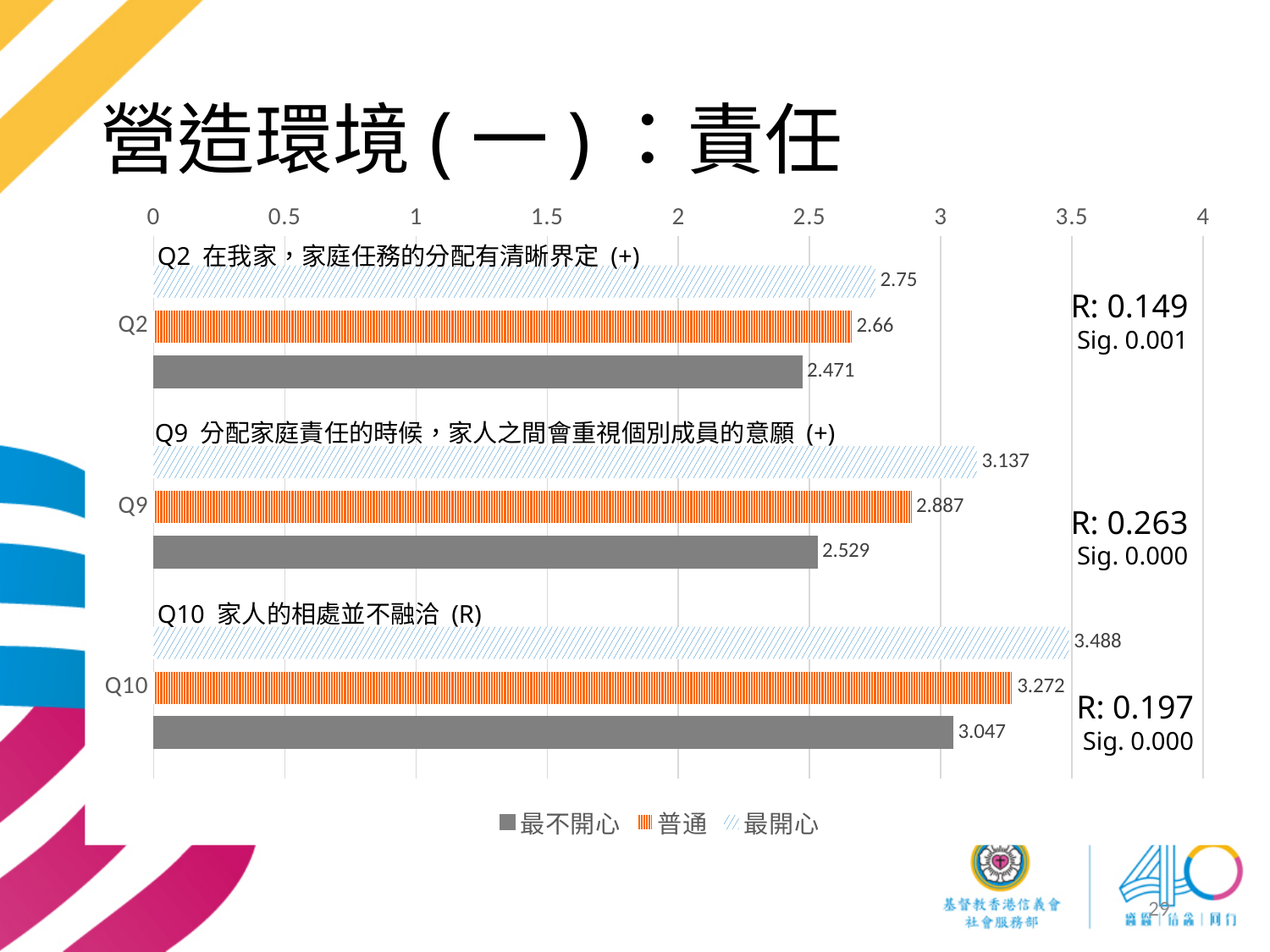
What is the value of 最不開心 for Q2? 2.471 What is the R value shown next to Q9? R: 0.263 What is the value of 最不開心 for Q10? 3.047 What is the value of 最開心 for Q2? 2.75 Which category has the lowest value for 普通? Q2 Which category has the highest value for 最開心? Q10 What kind of chart is shown on the slide? Bar chart What is the difference between the 最開心 and 最不開心 values for Q9? 0.608 Which is larger: the 普通 value for Q10 or the 最開心 value for Q9? 普通 value for Q10 What is the value of 普通 for Q9? 2.887 How many series does the legend list? 3 How many categories are shown on the chart? 3